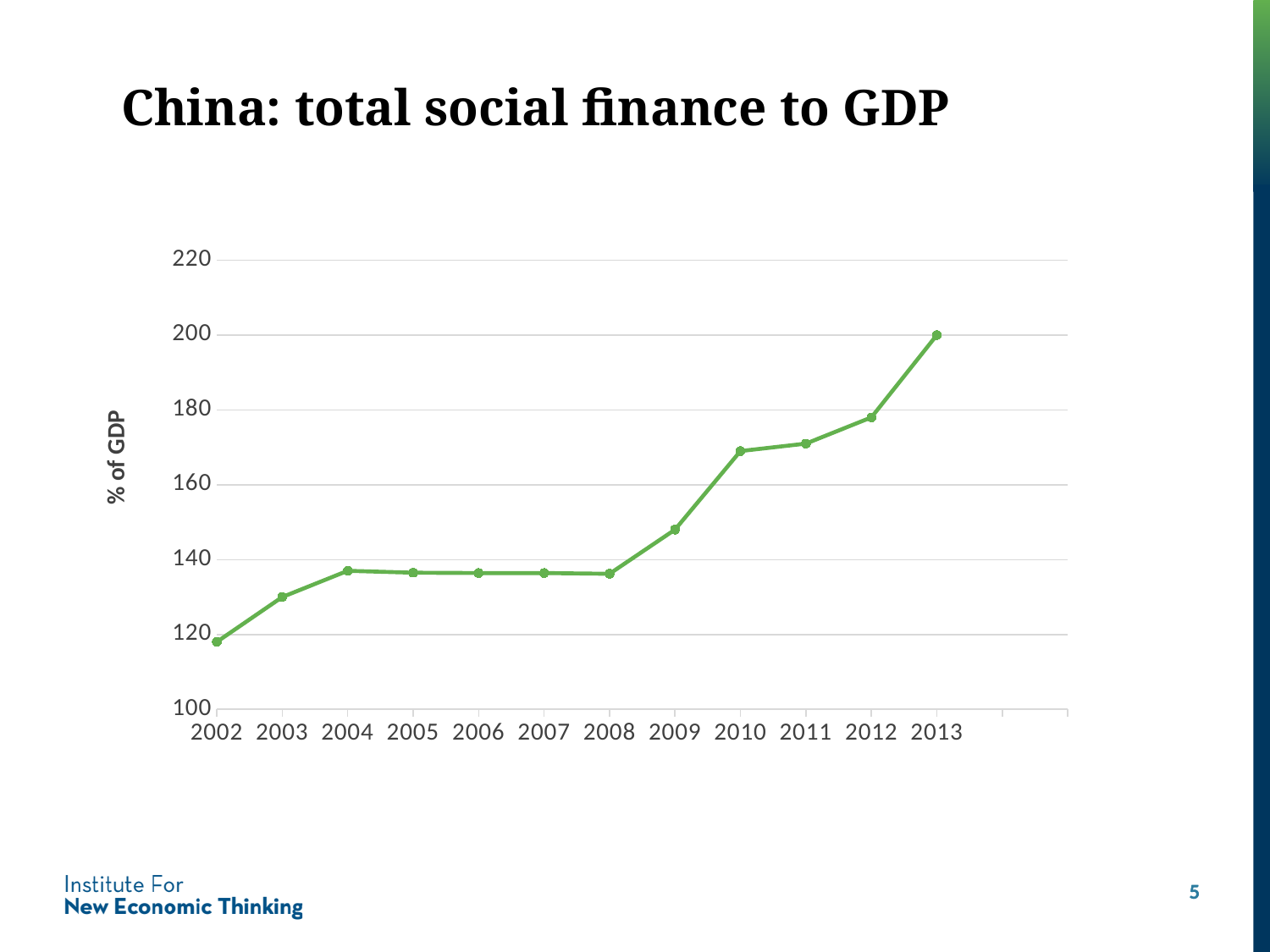
Which year has the highest value? 2013 What is the title of the chart? China: total social finance to GDP Is the value for 2012 greater or less than 180? less What is the value for 2013? 200 Which year has the lowest value? 2002 What kind of chart is shown on the slide? line chart How many years are plotted on the x axis? 12 Do the values generally rise or fall from 2002 to 2013? rise Is the value for 2002 greater or less than 120? less Which is larger, the value for 2010 or the value for 2004? 2010 What is the label on the vertical axis? % of GDP Is the value for 2009 greater or less than 140? greater